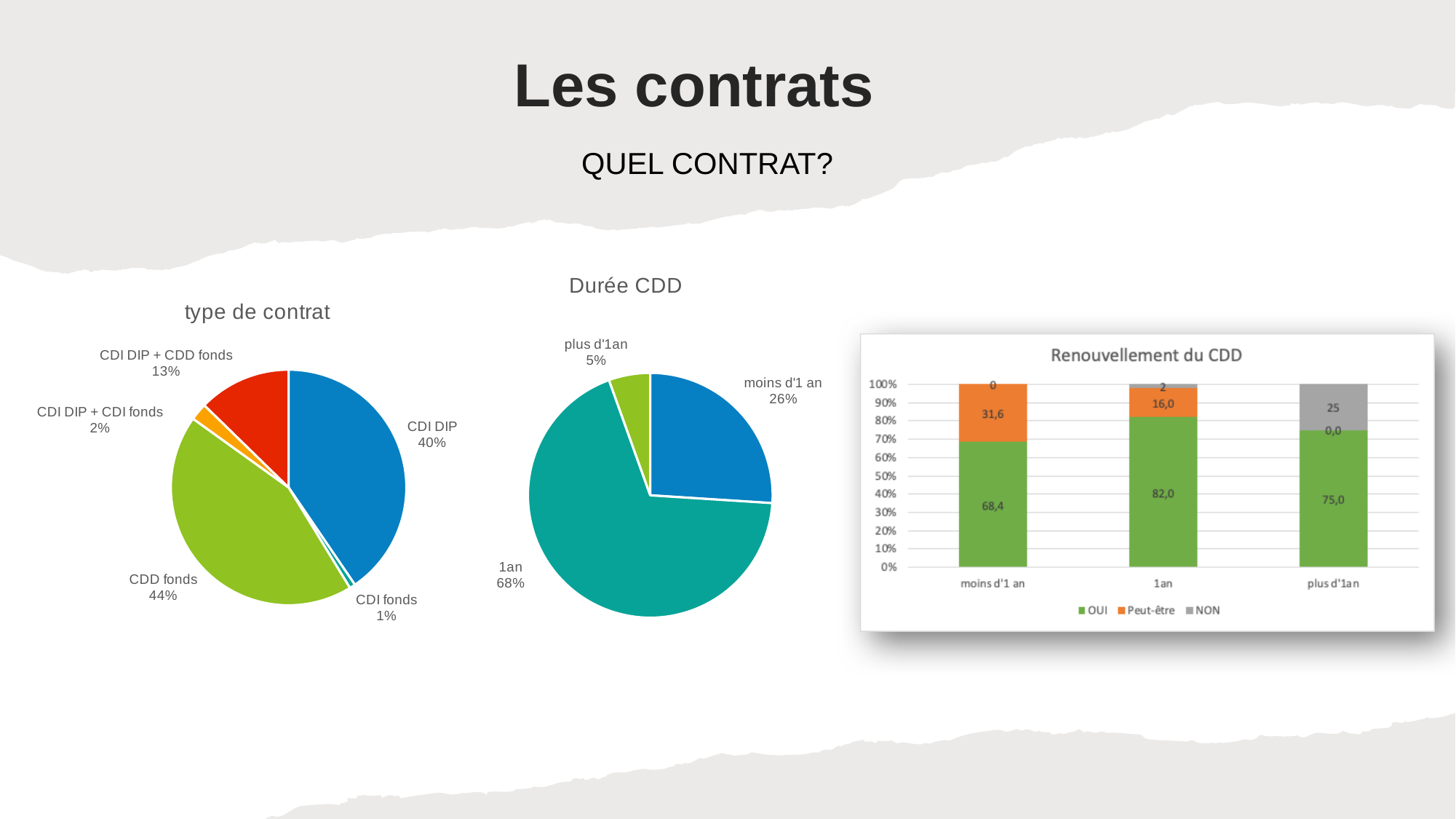
How many series does the legend of the 'Renouvellement du CDD' chart list? 3 In the 'Durée CDD' pie chart, which is larger: 'moins d'1 an' or 'plus d'1an'? moins d'1 an In the 'Renouvellement du CDD' chart, what is the OUI value for '1an'? 82,0 In the 'type de contrat' pie chart, which category has the largest share? CDD fonds In the 'Durée CDD' pie chart, what share does '1an' have? 68% In the 'type de contrat' pie chart, what share does CDD fonds have? 44% In the 'Renouvellement du CDD' chart, which category has the highest OUI value? 1an In the 'Renouvellement du CDD' chart, what is the Peut-être value for 'moins d'1 an'? 31,6 In the 'Durée CDD' pie chart, which category has the smallest share? plus d'1an In the 'type de contrat' pie chart, what is the difference between the CDI DIP share and the CDI DIP + CDD fonds share? 27% In the 'type de contrat' pie chart, how many categories are shown? 5 What kind of chart is 'Renouvellement du CDD'? Stacked bar chart